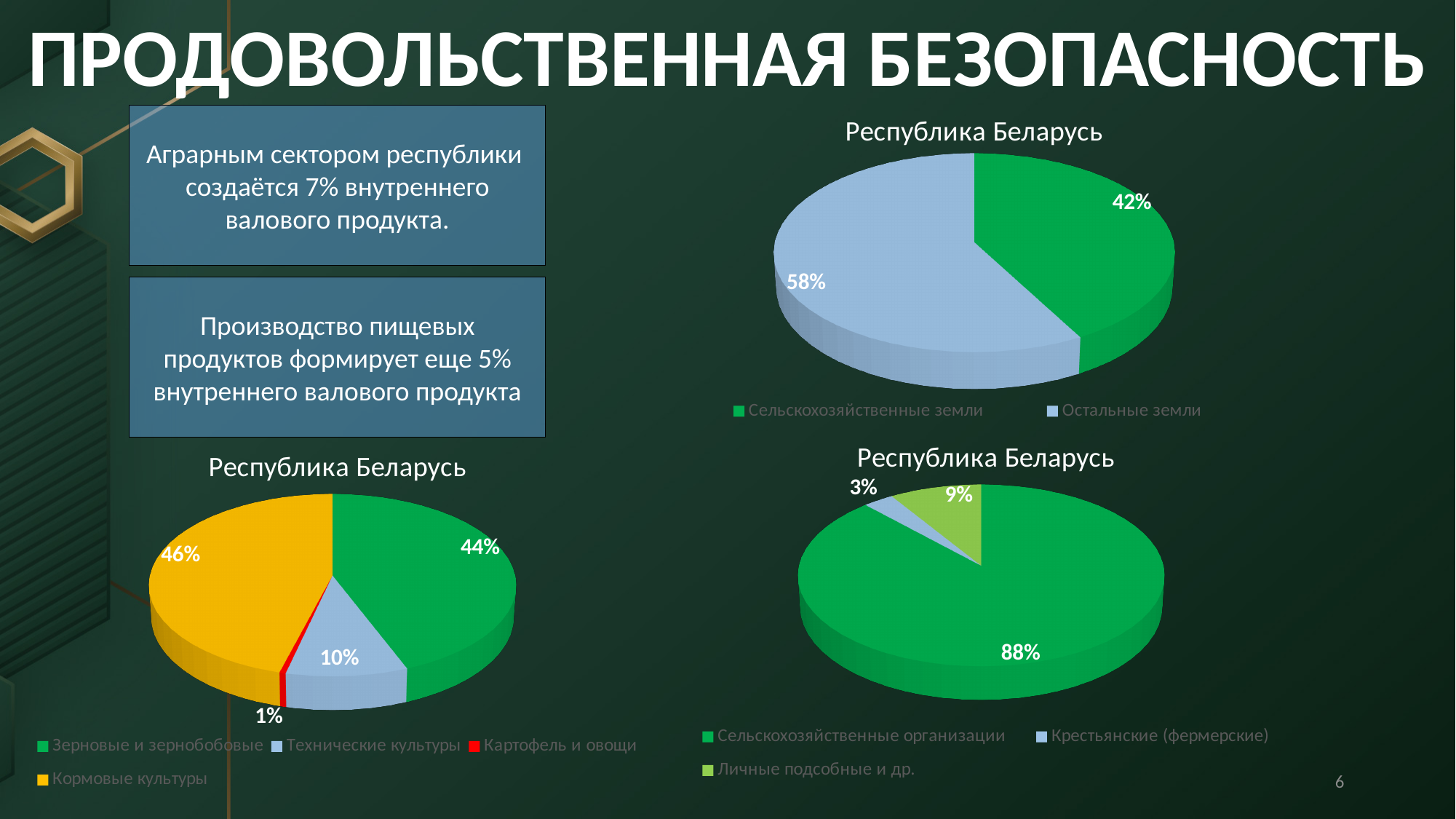
How many categories does the legend of the bottom-left pie chart list? 4 In the bottom-right pie chart, what share is labelled for Сельскохозяйственные организации? 88% In the bottom-left pie chart, what is the difference in percentage points between Зерновые и зернобобовые and Технические культуры? 34 In the bottom-left pie chart, which category has the smallest slice? Картофель и овощи What type of chart is the top-right chart on the slide? Pie chart In the top-right pie chart, which slice is larger: Сельскохозяйственные земли or Остальные земли? Остальные земли In the bottom-left pie chart, what share is labelled for Технические культуры? 10% In the bottom-right pie chart, what is the difference in percentage points between Личные подсобные и др. and Крестьянские (фермерские)? 6 In the bottom-left pie chart, which category has the largest slice? Кормовые культуры In the top-right pie chart, what share is labelled for Сельскохозяйственные земли? 42% In the bottom-right pie chart, what share is labelled for Крестьянские (фермерские)? 3% In the top-right pie chart, what share is labelled for Остальные земли? 58%